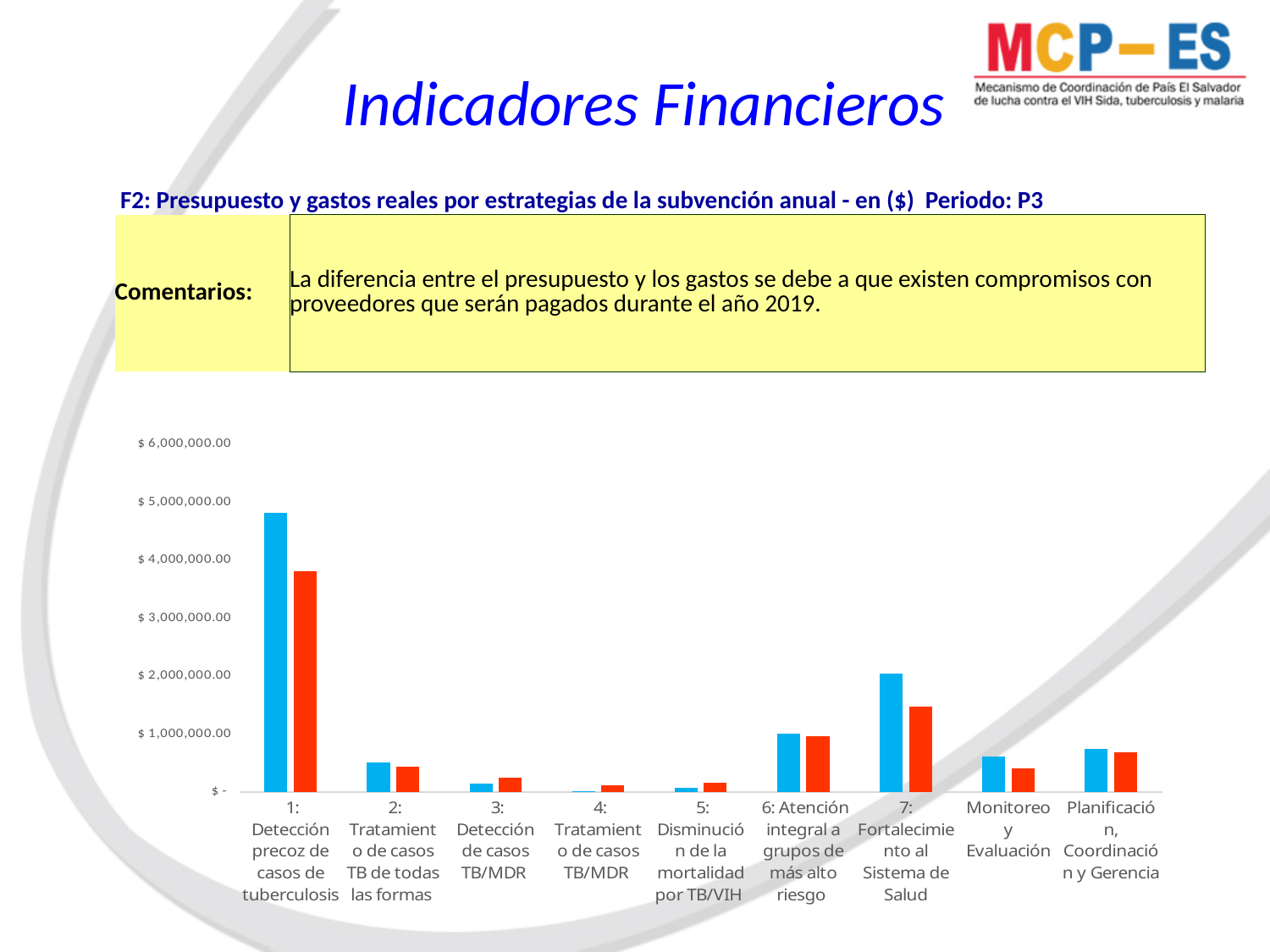
Which category has the tallest red bar in the chart? 1: Detección precoz de casos de tuberculosis Is the red bar for '1: Detección precoz de casos de tuberculosis' greater or less than $4,000,000.00? less How many categories (strategies) are shown along the x axis of the chart? 9 What is the period indicated in the heading above the chart? P3 Is the red bar for '7: Fortalecimiento al Sistema de Salud' greater or less than $1,000,000.00? greater For 'Monitoreo y Evaluación', which bar is taller, the blue one or the red one? the blue one Is the blue bar for '2: Tratamiento de casos TB de todas las formas' greater or less than $1,000,000.00? less Which category has the tallest blue bar in the chart? 1: Detección precoz de casos de tuberculosis What kind of chart is shown on the slide? bar chart For '3: Detección de casos TB/MDR', which bar is taller, the blue one or the red one? the red one Which category has the shortest blue bar in the chart? 4: Tratamiento de casos TB/MDR